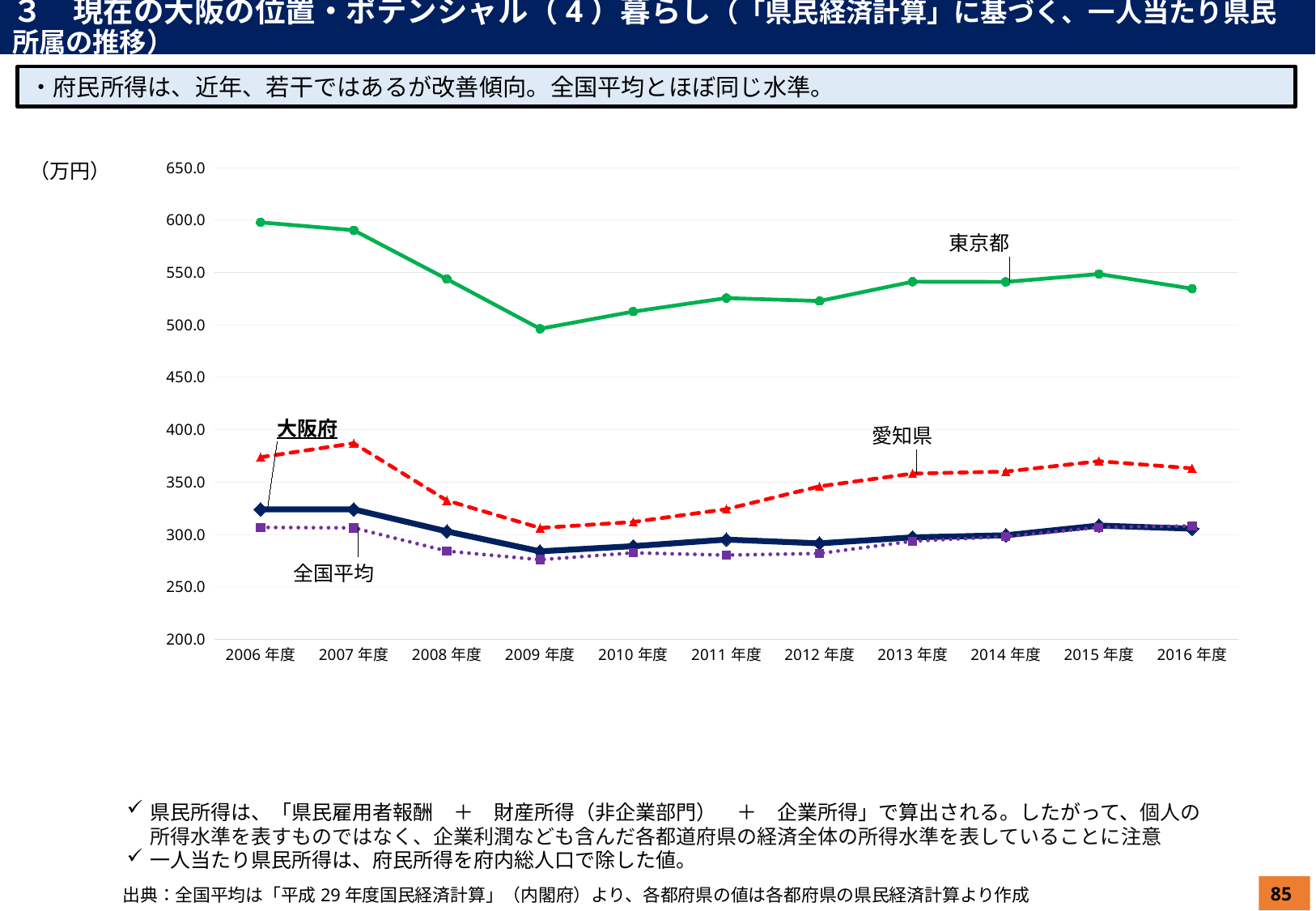
Is the value for 大阪府 in 2009 年度 greater or less than 300? less Is the value for 愛知県 in 2009 年度 greater or less than 350? less Does the 東京都 line rise or fall from 2006 年度 to 2009 年度? fall In which fiscal year is the 東京都 line at its lowest? 2009 年度 How many series (prefectures/averages) are plotted on the chart? 4 How many fiscal years are plotted along the x axis? 11 Which series has the highest values across all years? 東京都 What kind of chart is shown on the slide? line chart Is the value for 東京都 in 2006 年度 greater or less than 550? greater Which is larger in 2006 年度, 愛知県 or 大阪府? 愛知県 In which fiscal year is the 愛知県 line at its highest? 2007 年度 What unit is shown for the y axis of the chart? 万円